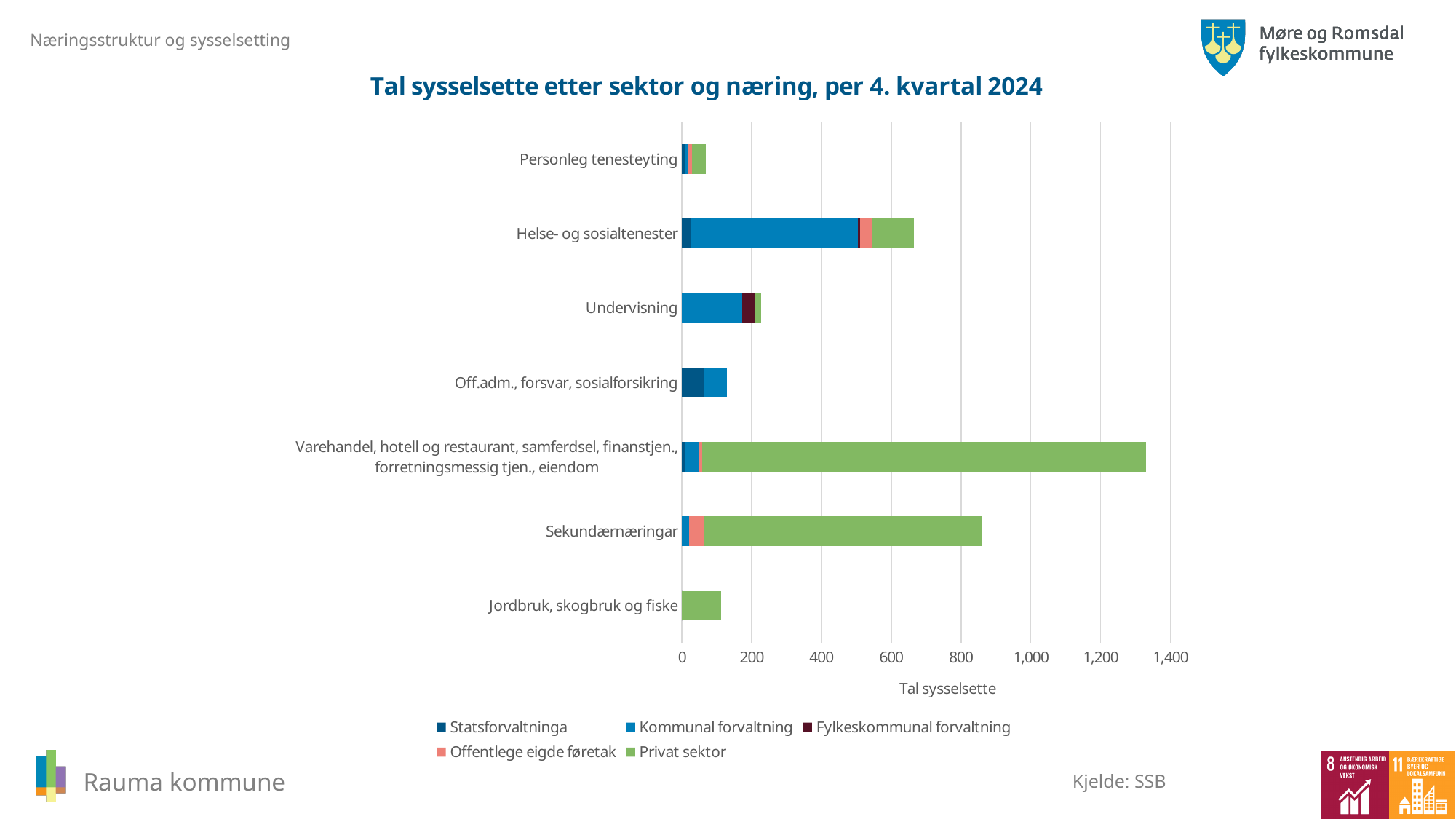
Is the total value for Sekundærnæringar greater or less than 800? greater How many categories (næringar) are shown on the y axis of the chart? 7 Is the total value for Jordbruk, skogbruk og fiske greater or less than 200? less Which category has the longest total bar? Varehandel, hotell og restaurant, samferdsel, finanstjen., forretningsmessig tjen., eiendom Which has the larger total bar, Sekundærnæringar or Helse- og sosialtenester? Sekundærnæringar What is the title of the chart? Tal sysselsette etter sektor og næring, per 4. kvartal 2024 Is the total value for Varehandel, hotell og restaurant, samferdsel, finanstjen., forretningsmessig tjen., eiendom greater or less than 1,200? greater How many series does the legend list? 5 What is the label on the x axis of the chart? Tal sysselsette Which category has the shortest total bar? Personleg tenesteyting What kind of chart is shown on the slide? Stacked bar chart